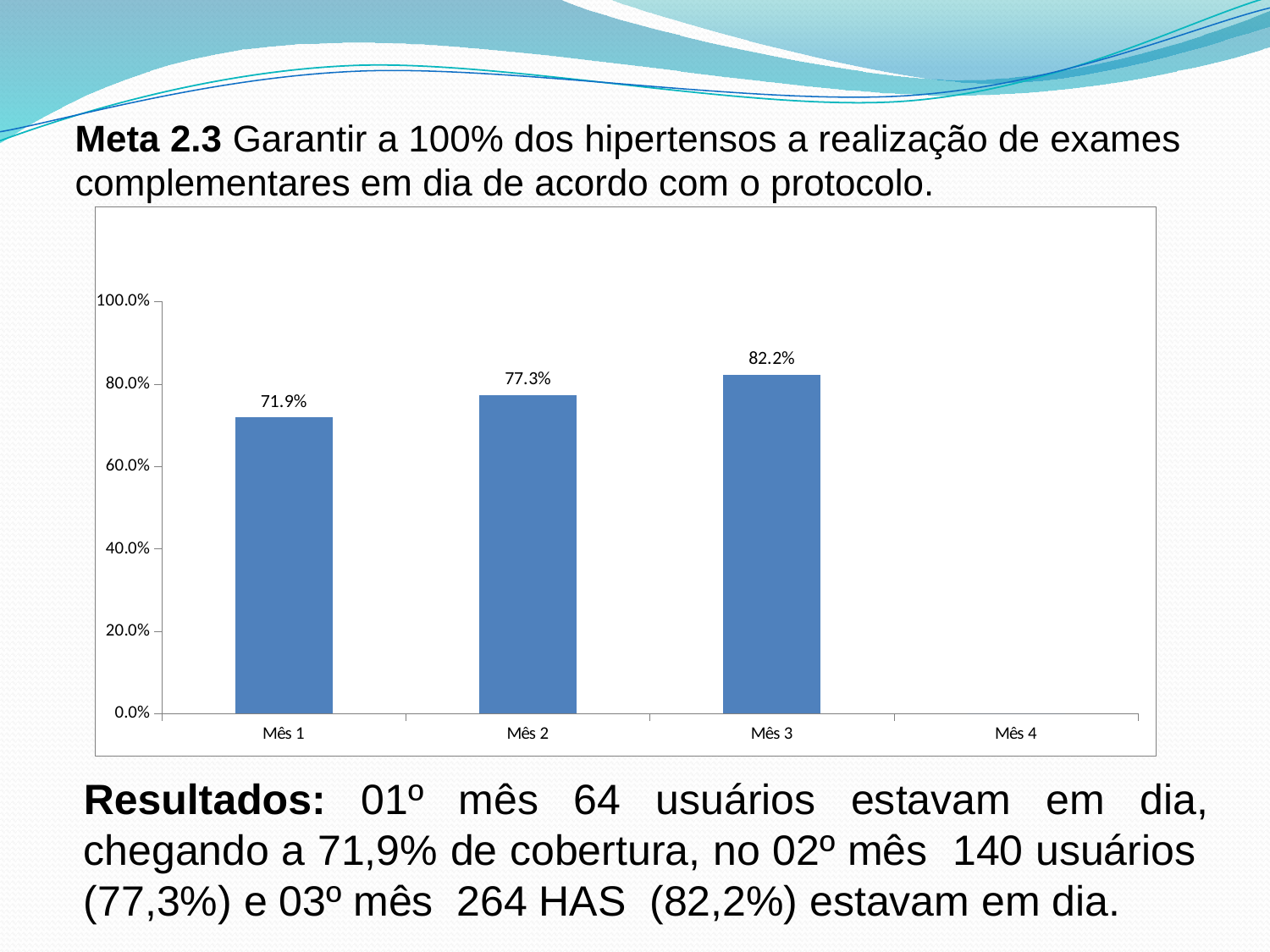
Which month has the highest value? Mês 3 Do the values rise or fall from Mês 1 to Mês 3? rise What is the difference between the values for Mês 2 and Mês 1? 5.4 percentage points Is the value for Mês 1 greater or less than 80.0%? less How many bars are plotted in the chart? 3 What is the value shown for Mês 2? 77.3% What is the value shown for Mês 3? 82.2% Which month with a plotted bar has the lowest value? Mês 1 What is the value shown for Mês 1? 71.9% Which is larger, the value for Mês 2 or the value for Mês 3? Mês 3 What kind of chart is shown on the slide? bar chart What is the difference between the values for Mês 3 and Mês 1? 10.3 percentage points